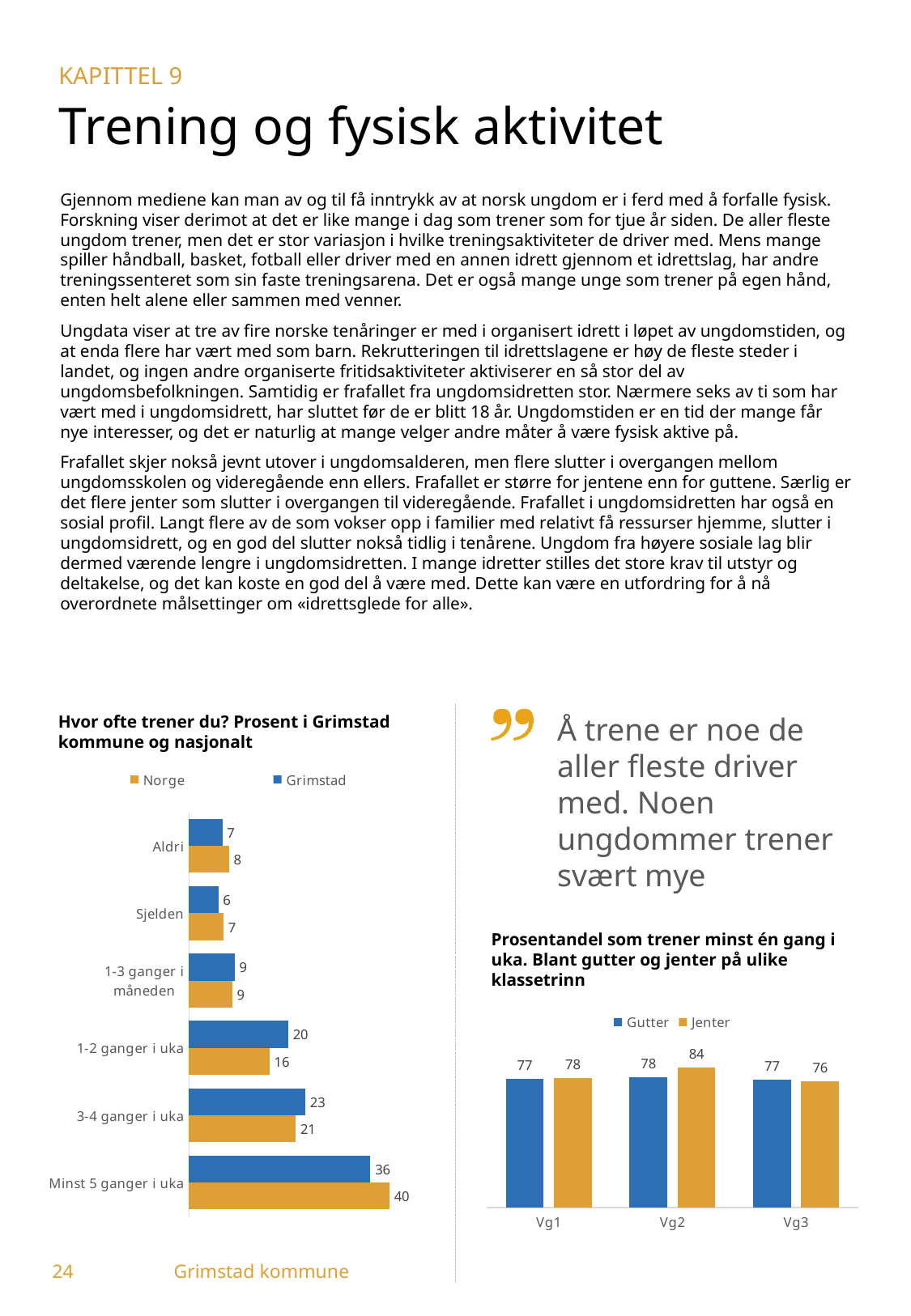
In the chart 'Hvor ofte trener du?', what is the Norge value for '1-2 ganger i uka'? 16 In the chart 'Hvor ofte trener du?', which category has the highest Norge value? Minst 5 ganger i uka In the chart 'Hvor ofte trener du?', which category has the lowest Grimstad value? Sjelden In the chart 'Hvor ofte trener du?', what type of chart is used? Bar chart In the chart 'Prosentandel som trener minst én gang i uka', what is the Gutter value for Vg3? 77 In the chart 'Hvor ofte trener du?', how many categories are shown? 6 In the chart 'Prosentandel som trener minst én gang i uka', how many series does the legend list? 2 In the chart 'Prosentandel som trener minst én gang i uka', what is the difference between Jenter and Gutter for Vg2? 6 In the chart 'Prosentandel som trener minst én gang i uka', which is larger for Vg2: Gutter or Jenter? Jenter In the chart 'Hvor ofte trener du?', what is the Grimstad value for 'Minst 5 ganger i uka'? 36 In the chart 'Prosentandel som trener minst én gang i uka', what is the Jenter value for Vg2? 84 In the chart 'Hvor ofte trener du?', what is the difference between the Norge and Grimstad values for 'Minst 5 ganger i uka'? 4